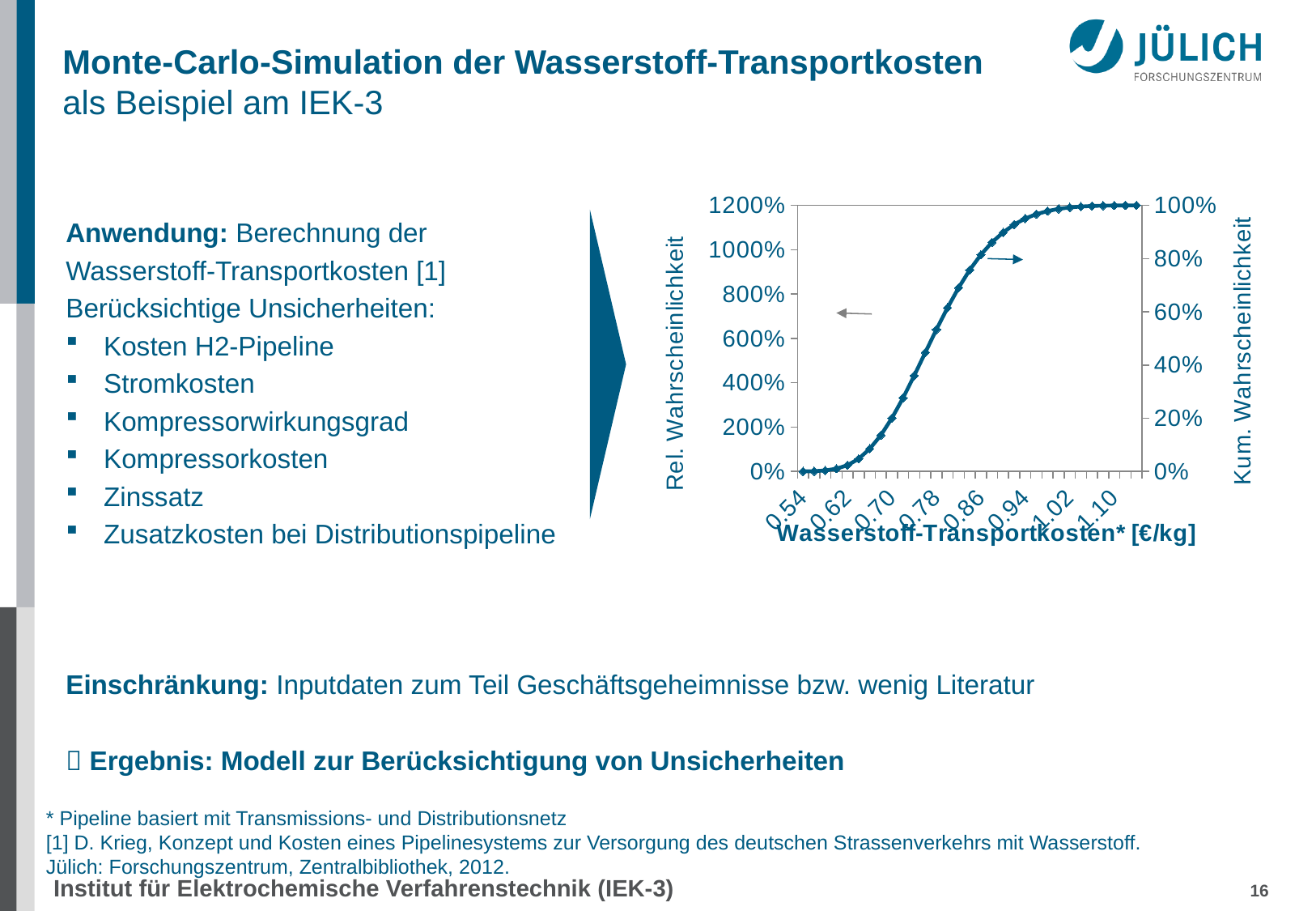
Is the cumulative probability (right axis) at a transport cost of 0.62 €/kg greater or less than 20%? less Is the cumulative probability (right axis) at a transport cost of 0.94 €/kg greater or less than 80%? greater What is the label of the x axis of the chart? Wasserstoff-Transportkosten* [€/kg] Is the cumulative probability (right axis) at a transport cost of 1.10 €/kg greater or less than 80%? greater What is the highest value shown on the right y axis of the chart? 100% Which x-axis tick has the higher cumulative probability, 0.70 €/kg or 1.02 €/kg? 1.02 €/kg Does the plotted curve rise or fall as the transport cost increases along the x axis? rise What is the highest value shown on the left y axis of the chart? 1200% What is the label of the right-hand y axis of the chart? Kum. Wahrscheinlichkeit What kind of chart is shown on the slide? line chart How many tick labels are printed on the x axis of the chart? 8